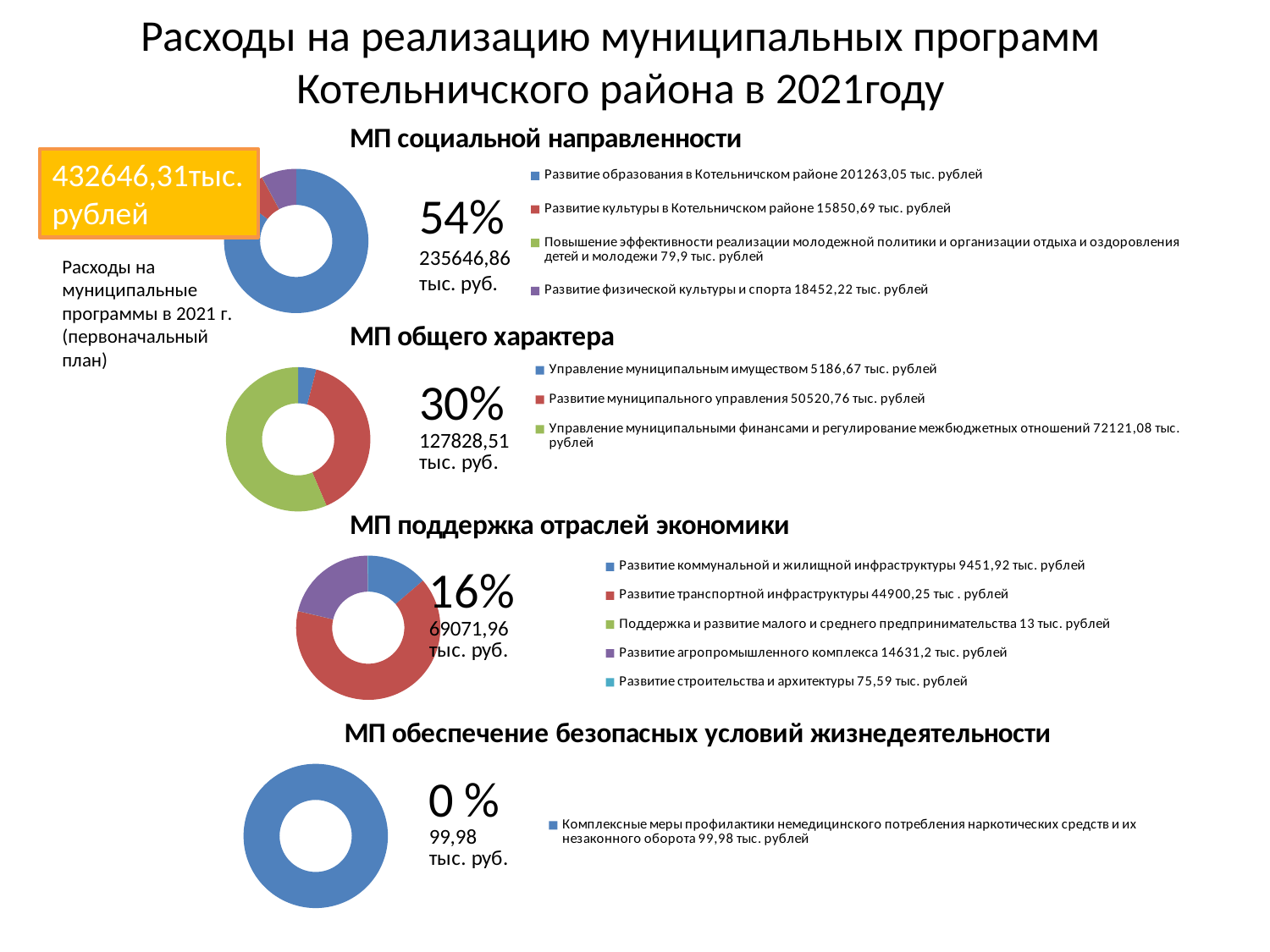
What kind of chart is used for "МП социальной направленности"? doughnut chart In the "МП социальной направленности" chart, which category has the smallest value? Повышение эффективности реализации молодежной политики и организации отдыха и оздоровления детей и молодежи In the "МП социальной направленности" chart, what is the value for "Развитие образования в Котельничском районе"? 201263,05 тыс. рублей In the "МП общего характера" chart, what is the value for "Управление муниципальным имуществом"? 5186,67 тыс. рублей In the "МП поддержка отраслей экономики" chart, how many categories does the legend list? 5 In the "МП поддержка отраслей экономики" chart, what is the value for "Поддержка и развитие малого и среднего предпринимательства"? 13 тыс. рублей In the "МП социальной направленности" chart, how many categories does the legend list? 4 In the "МП обеспечение безопасных условий жизнедеятельности" chart, what is the value for "Комплексные меры профилактики немедицинского потребления наркотических средств и их незаконного оборота"? 99,98 тыс. рублей In the "МП поддержка отраслей экономики" chart, which is larger: "Развитие транспортной инфраструктуры" or "Развитие агропромышленного комплекса"? Развитие транспортной инфраструктуры In the "МП общего характера" chart, what is the difference between "Управление муниципальными финансами и регулирование межбюджетных отношений" and "Развитие муниципального управления"? 21600,32 тыс. рублей In the "МП общего характера" chart, which category has the largest value? Управление муниципальными финансами и регулирование межбюджетных отношений What percentage is shown next to the "МП поддержка отраслей экономики" chart? 16%